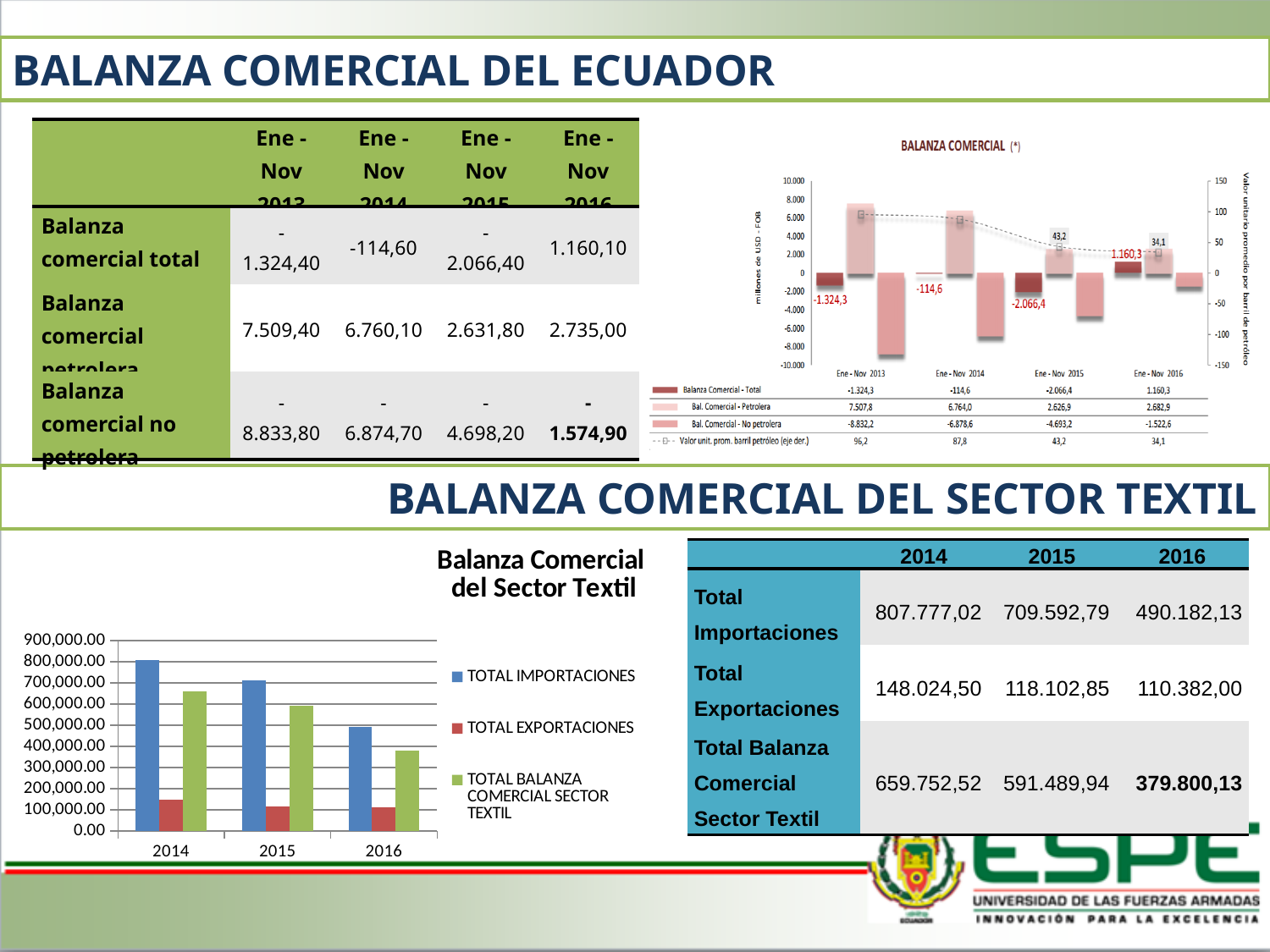
In the 'Balanza Comercial del Sector Textil' chart, which year has the highest TOTAL BALANZA COMERCIAL SECTOR TEXTIL bar? 2014 What kind of chart is the 'Balanza Comercial del Sector Textil' chart? bar chart In the 'Balanza Comercial del Sector Textil' chart, is the TOTAL EXPORTACIONES value for 2015 greater or less than 200,000.00? less In the 'Balanza Comercial del Sector Textil' chart, do the TOTAL IMPORTACIONES bars rise or fall from 2014 to 2016? fall In the 'BALANZA COMERCIAL (*)' chart at the top right, what is the Balanza Comercial - Total value labelled for Ene - Nov 2015? -2.066,4 In the 'Balanza Comercial del Sector Textil' chart, which is larger in 2015: TOTAL IMPORTACIONES or TOTAL BALANZA COMERCIAL SECTOR TEXTIL? TOTAL IMPORTACIONES In the 'Balanza Comercial del Sector Textil' chart, which series has the lowest bar in every year? TOTAL EXPORTACIONES In the 'Balanza Comercial del Sector Textil' chart, how many year categories are shown on the x axis? 3 In the 'Balanza Comercial del Sector Textil' chart, how many series does the legend list? 3 In the 'BALANZA COMERCIAL (*)' chart at the top right, what is the Balanza Comercial - Total value labelled for Ene - Nov 2016? 1.160,3 In the 'Balanza Comercial del Sector Textil' chart, is the TOTAL IMPORTACIONES value for 2014 greater or less than 800,000.00? greater In the 'Balanza Comercial del Sector Textil' chart, is the TOTAL IMPORTACIONES value for 2016 greater or less than 500,000.00? less